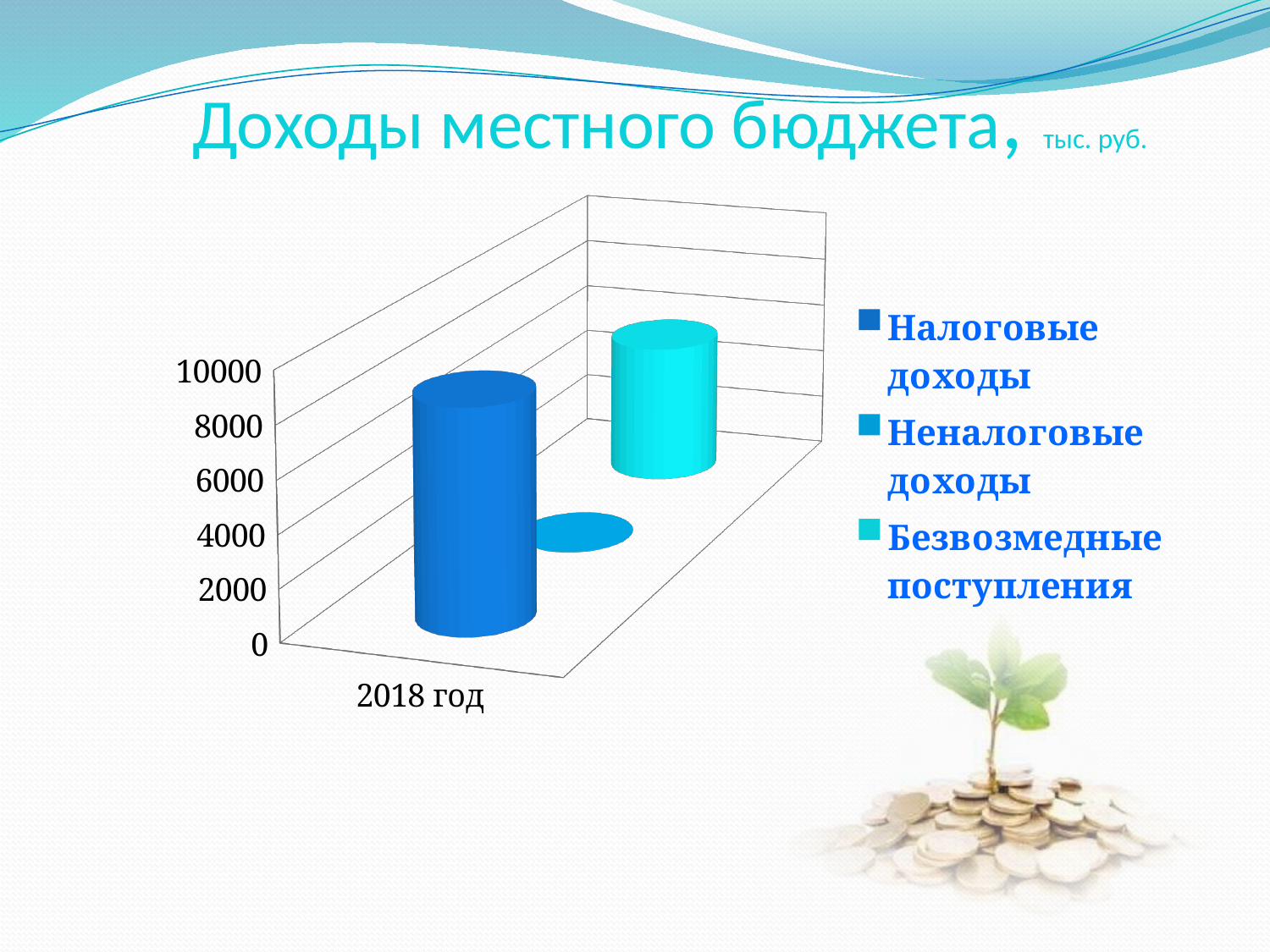
What is the category label shown on the x axis of the chart? 2018 год Is the value for Налоговые доходы in 2018 год greater or less than 6000? greater Is the value for Безвозмедные поступления in 2018 год greater or less than 2000? greater How many series does the chart legend list? 3 Which series has the highest value for 2018 год? Налоговые доходы Which series has the lowest value for 2018 год? Неналоговые доходы How many categories are shown on the x axis of the chart? 1 Is the value for Неналоговые доходы in 2018 год greater or less than 2000? less What kind of chart is shown on the slide? bar chart Which is larger for 2018 год: Налоговые доходы or Безвозмедные поступления? Налоговые доходы What is the title of the chart on the slide? Доходы местного бюджета, тыс. руб.